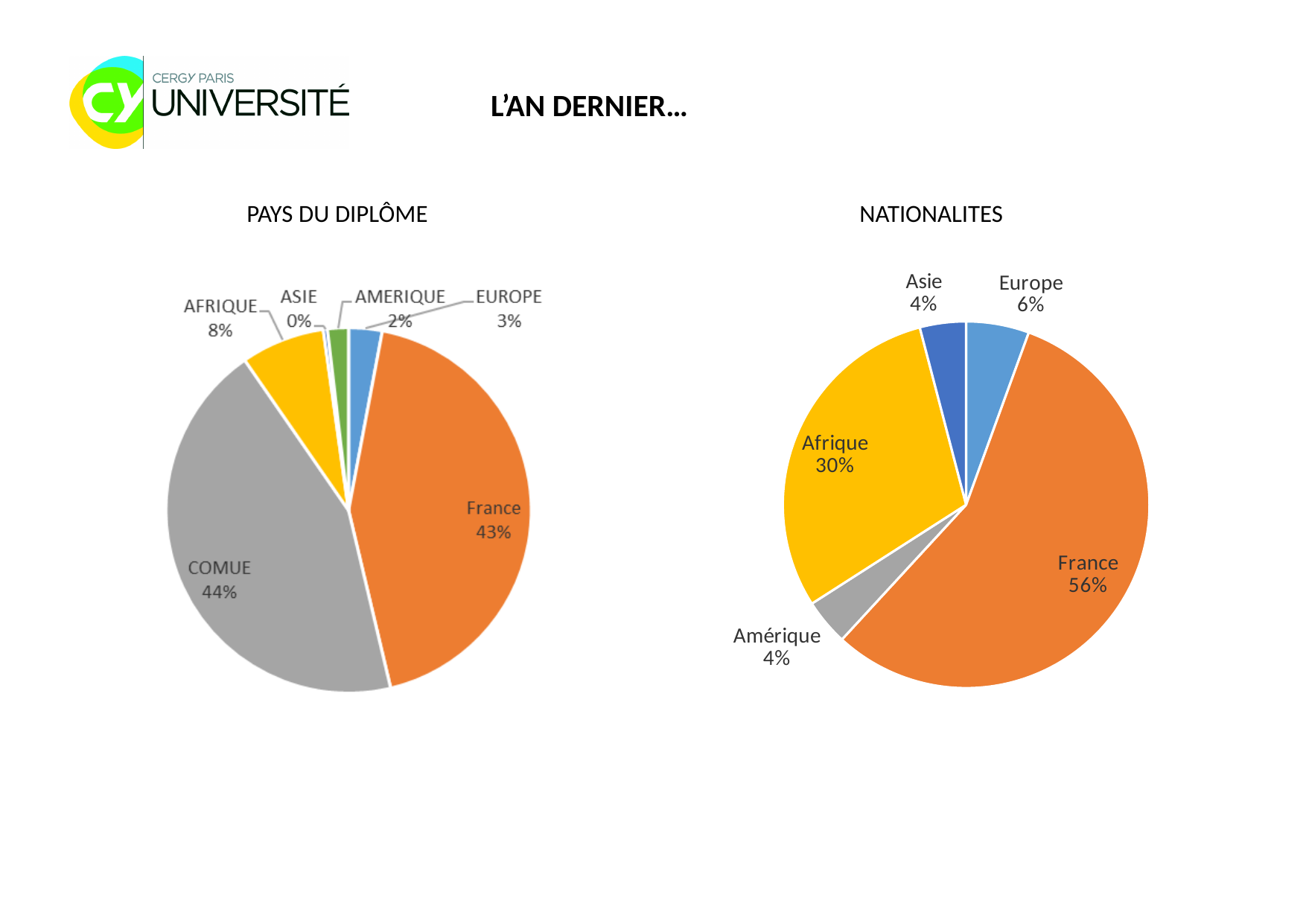
In the NATIONALITES chart, what share does Afrique have? 30% In the NATIONALITES chart, how many categories are shown? 5 In the PAYS DU DIPLÔME chart, what is the difference between the EUROPE and AMERIQUE shares? 1% In the NATIONALITES chart, what share does France have? 56% In the PAYS DU DIPLÔME chart, what share does AFRIQUE have? 8% In the NATIONALITES chart, what is the difference between the France and Afrique shares? 26% In the PAYS DU DIPLÔME chart, what share does France have? 43% What type of chart is the NATIONALITES chart? Pie chart In the PAYS DU DIPLÔME chart, how many categories are shown? 6 In the PAYS DU DIPLÔME chart, which category has the smallest share? ASIE In the PAYS DU DIPLÔME chart, what share does COMUE have? 44% In the NATIONALITES chart, which category has the largest share? France